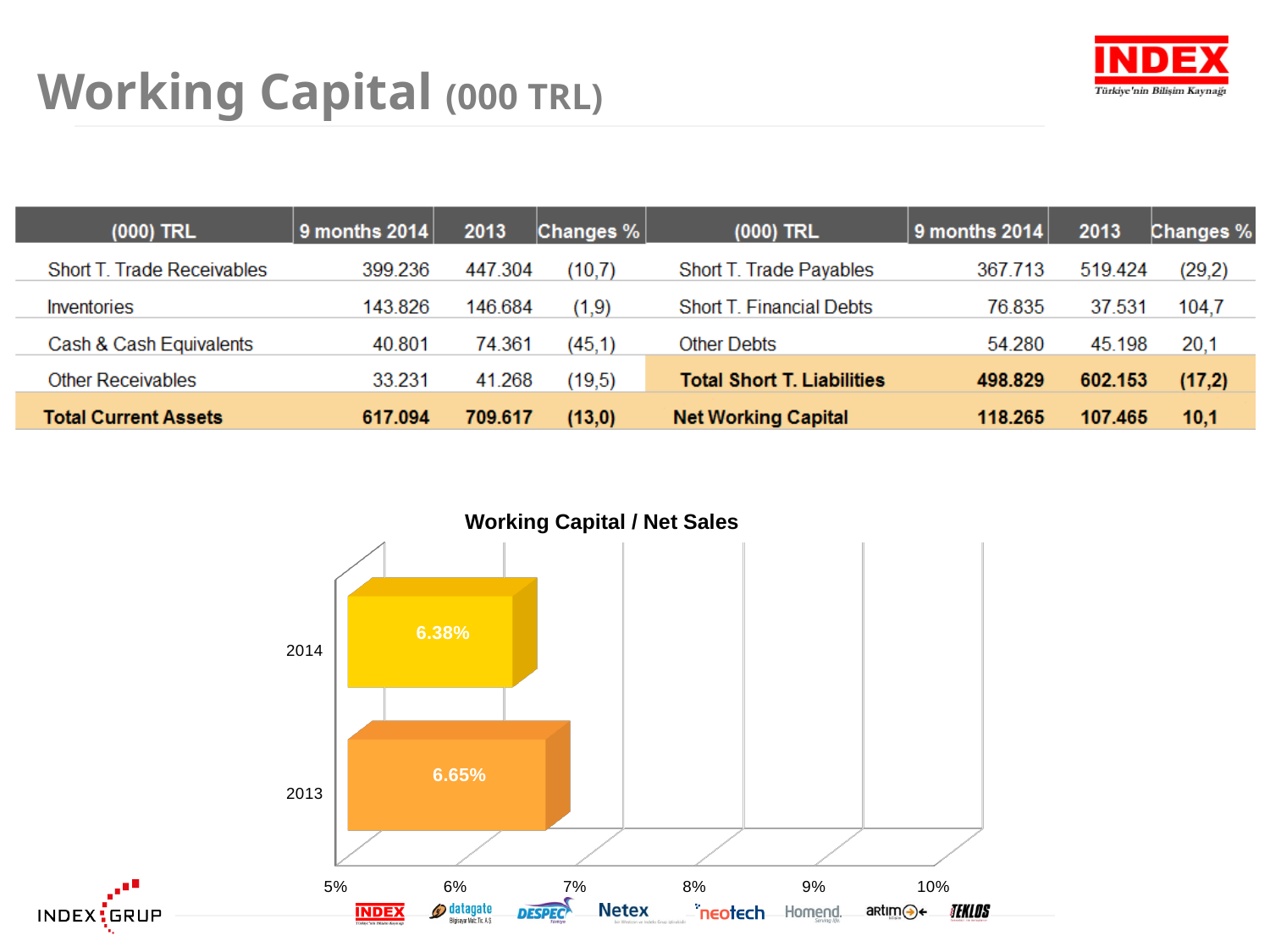
What is the value for 2013 in the Working Capital / Net Sales chart? 6.65% In the Working Capital / Net Sales chart, did the ratio rise or fall from 2013 to 2014? fall In the Working Capital / Net Sales chart, by how many percentage points does the 2013 value exceed the 2014 value? 0.27 percentage points In the Working Capital / Net Sales chart, is the value for 2014 greater or less than 7%? less In the Working Capital / Net Sales chart, which year has the higher value? 2013 What is the title of the chart on the slide? Working Capital / Net Sales How many bars are shown in the Working Capital / Net Sales chart? 2 In the Working Capital / Net Sales chart, which year has the lower value? 2014 In the Working Capital / Net Sales chart, is the value for 2014 larger or smaller than the value for 2013? smaller What is the value for 2014 in the Working Capital / Net Sales chart? 6.38% What kind of chart is the Working Capital / Net Sales chart? bar chart In the Working Capital / Net Sales chart, is the value for 2013 greater or less than 6%? greater